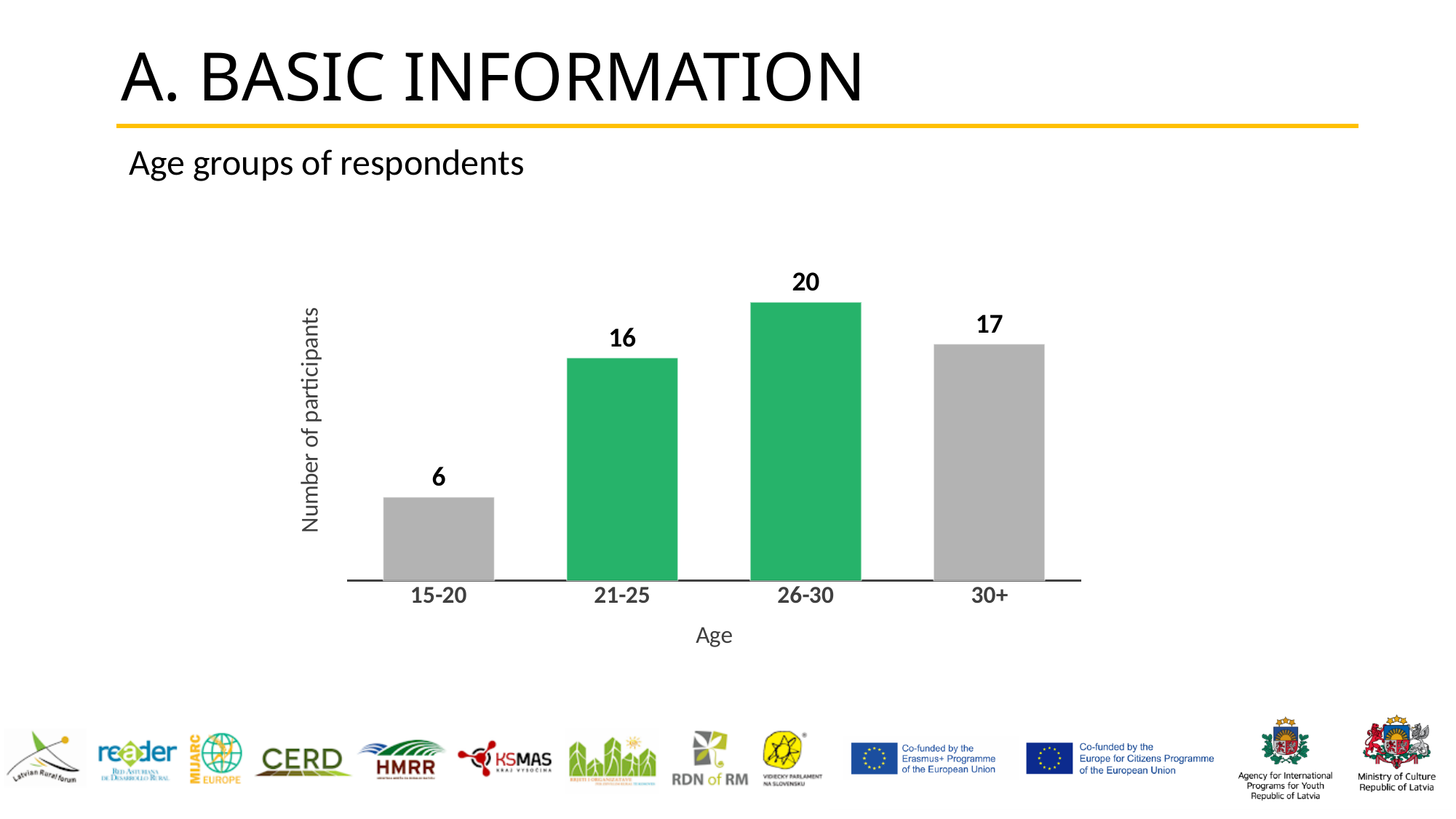
How many participants are in the 30+ age group? 17 Which age groups are shown with green bars? 21-25 and 26-30 How many participants are in the 21-25 age group? 16 Which age group has the lowest number of participants? 15-20 How many participants are in the 26-30 age group? 20 What is the label of the vertical axis? Number of participants How many participants are in the 15-20 age group? 6 What kind of chart is used to show the age groups of respondents? Bar chart What is the difference in number of participants between the 26-30 and 15-20 age groups? 14 Which age group has more participants, 21-25 or 30+? 30+ How many age groups are shown on the chart? 4 Which age group has the highest number of participants? 26-30